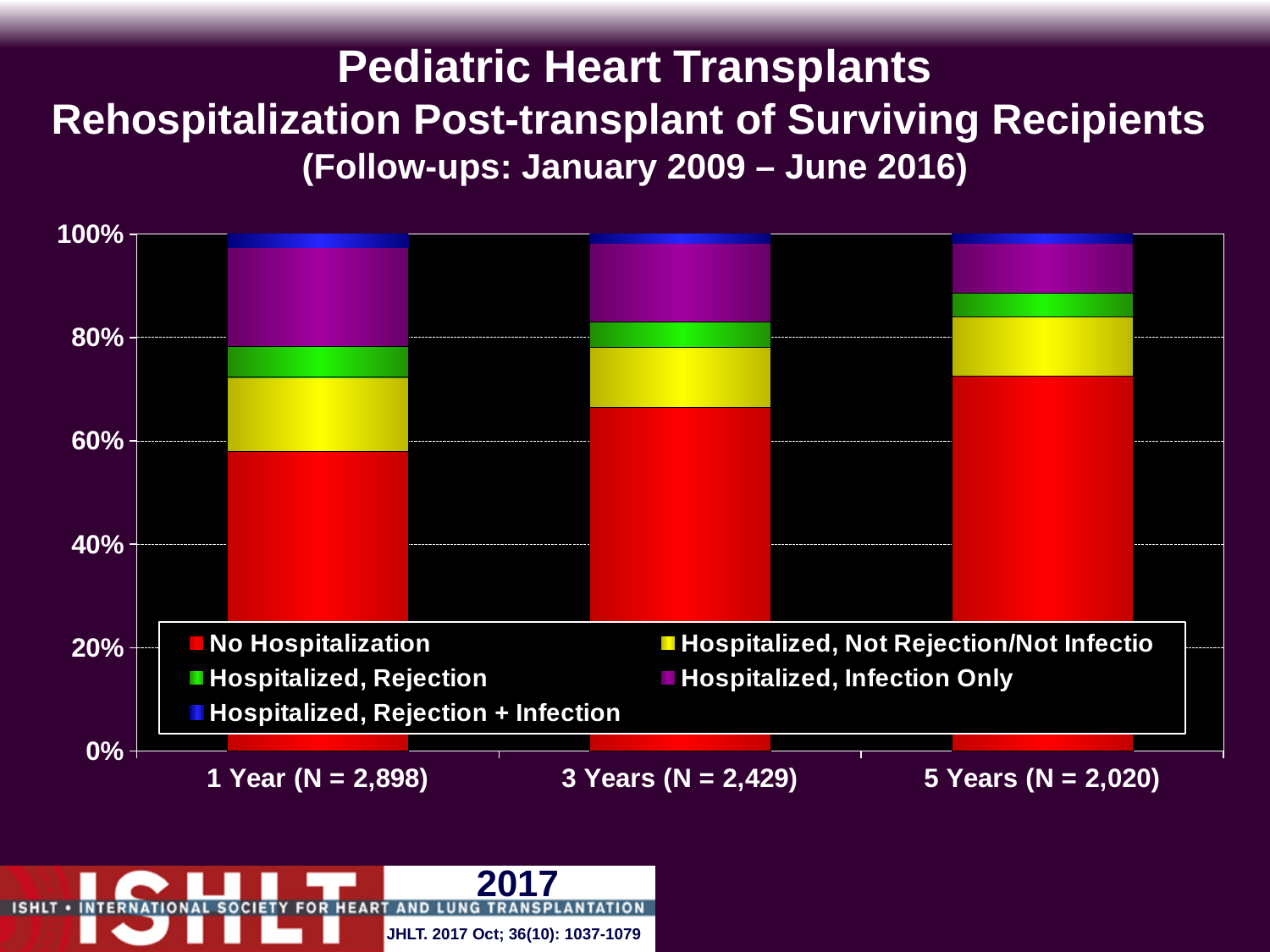
Does the No Hospitalization share rise or fall from 1 Year to 5 Years? Rise What kind of chart is shown on the slide? Stacked bar chart How many time-point categories are shown on the x axis? 3 Which time point has the largest No Hospitalization share? 5 Years (N = 2,020) What is the N shown for the 3 Years category? 2,429 What colour represents No Hospitalization in the legend? Red Is the No Hospitalization share for 5 Years (N = 2,020) greater or less than 80%? less Which time point has the smallest No Hospitalization share? 1 Year (N = 2,898) How many series does the legend list? 5 Is the No Hospitalization share for 1 Year (N = 2,898) greater or less than 60%? less Is the No Hospitalization share larger at 1 Year or at 3 Years? 3 Years Is the No Hospitalization share for 3 Years (N = 2,429) greater or less than 60%? greater